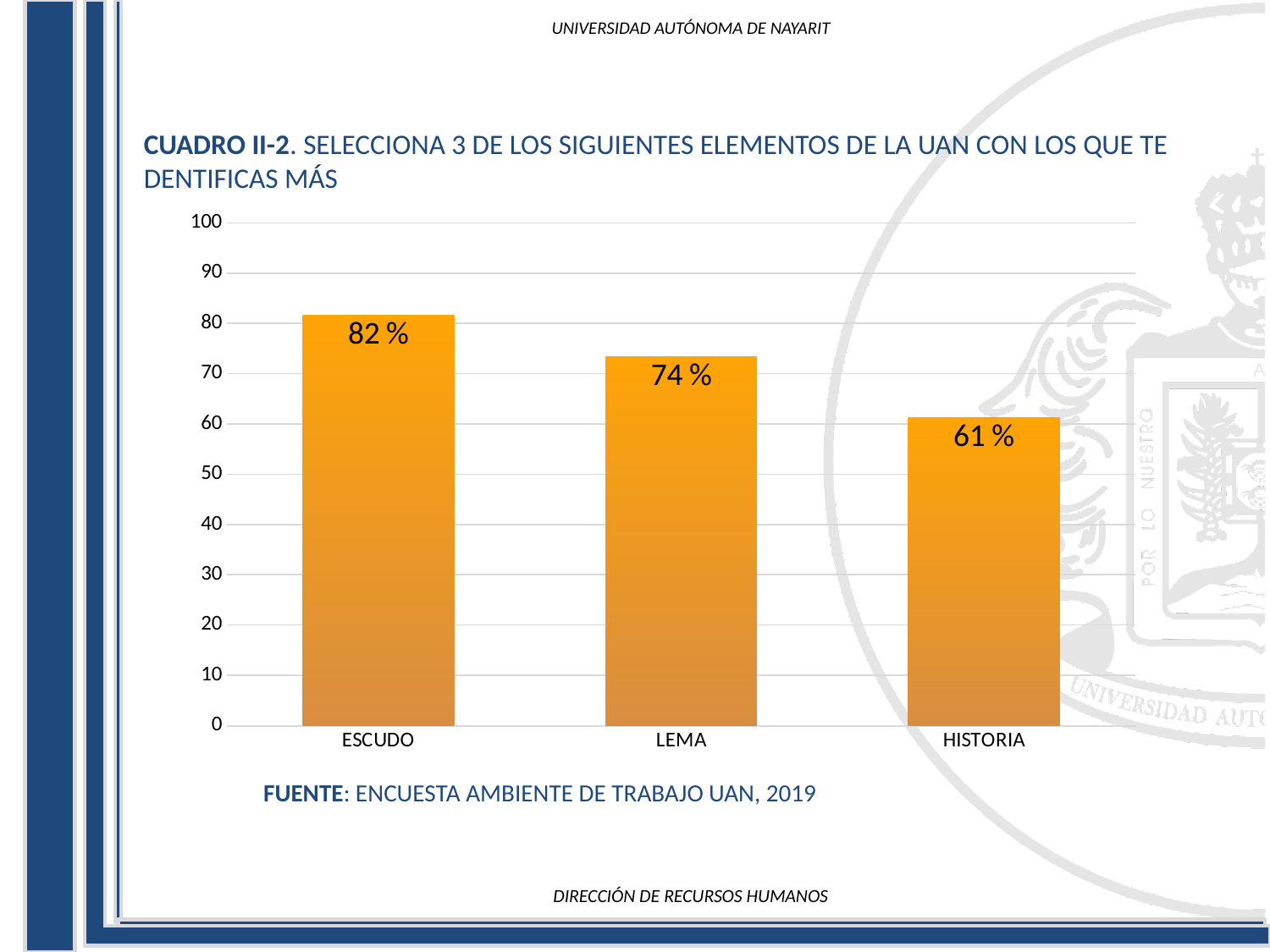
Is the value for HISTORIA greater or less than 70? less What kind of chart is shown on the slide? bar chart Which category has the lowest value? HISTORIA What is the difference between the values for ESCUDO and HISTORIA? 21 % What is the value for ESCUDO? 82 % Do the values rise or fall from left to right along the x axis? fall Which is larger, the value for LEMA or the value for HISTORIA? LEMA What is the value for LEMA? 74 % How many categories are shown on the x axis? 3 What is the difference between the values for ESCUDO and LEMA? 8 % What is the value for HISTORIA? 61 % Which category has the highest value? ESCUDO